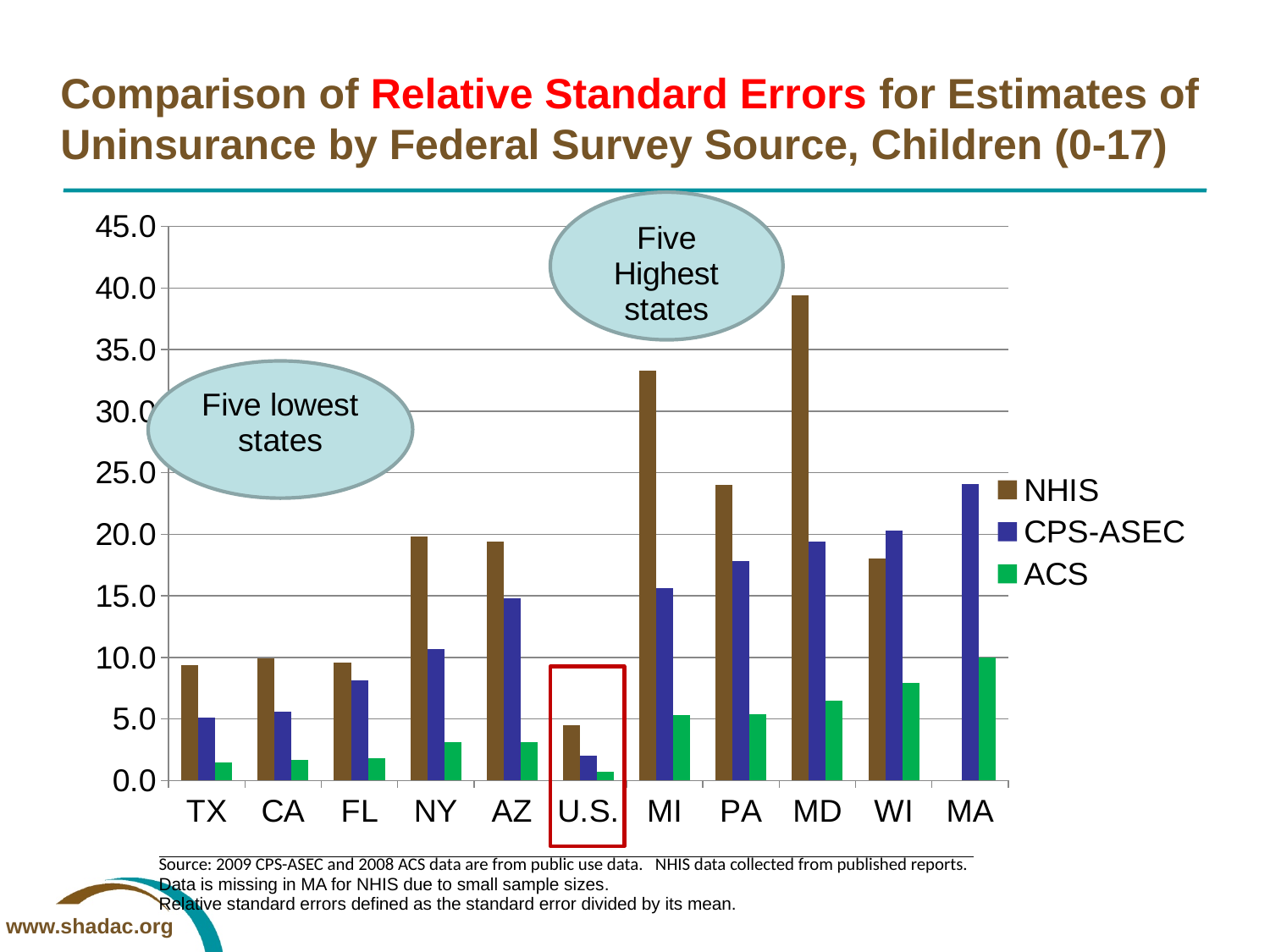
Which category has no NHIS bar plotted? MA How many categories are shown along the x axis? 11 Which category has the lowest ACS value? U.S. How many series does the legend list? 3 Which category has the highest NHIS value? MD What kind of chart is shown on the slide? Bar chart Is the NHIS value for TX greater or less than 10.0? less Which category has the highest CPS-ASEC value? MA Is the NHIS value for MD greater or less than 35.0? greater Is the NHIS value for MI greater or less than 30.0? greater Which is larger, the NHIS value for MD or the NHIS value for MI? MD